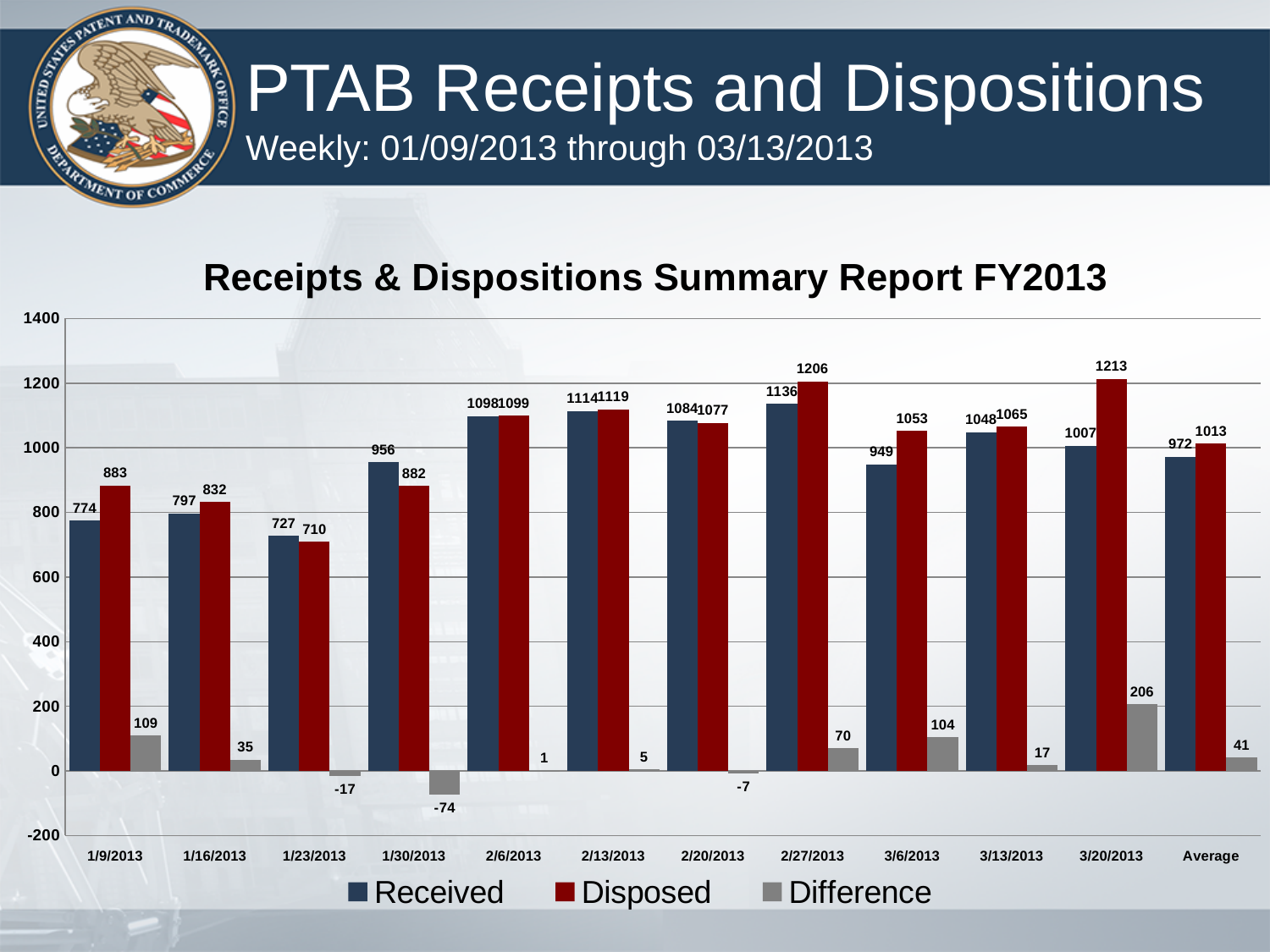
Which week has the lowest Received value? 1/23/2013 What is the Difference value for 1/30/2013? -74 How many series does the legend list? 3 How many categories are shown along the x axis? 12 What is the title of the chart? Receipts & Dispositions Summary Report FY2013 Which is larger for 3/6/2013, Received or Disposed? Disposed What is the Average Disposed value? 1013 What is the Disposed value for 2/27/2013? 1206 What type of chart is shown on the slide? Bar chart What is the Received value for 1/30/2013? 956 Which week has the highest Disposed value? 3/20/2013 What is the difference between Disposed and Received for 2/27/2013? 70